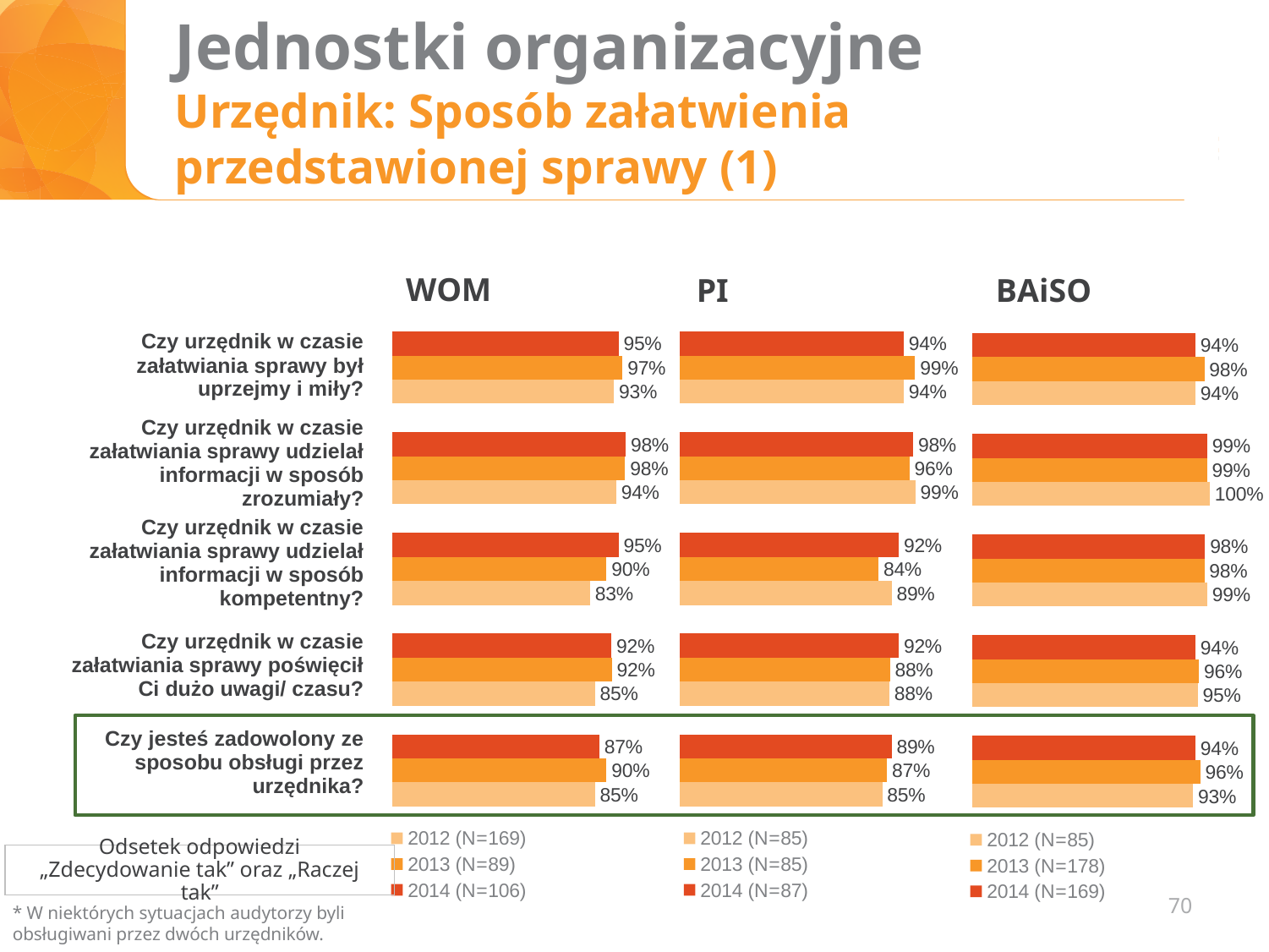
In the PI chart, which year has the highest value for "Czy urzędnik w czasie załatwiania sprawy był uprzejmy i miły?"? 2013 In the WOM chart, which year has the lowest value for "Czy urzędnik w czasie załatwiania sprawy udzielał informacji w sposób kompetentny?"? 2012 In the BAiSO chart, which is larger for "Czy jesteś zadowolony ze sposobu obsługi przez urzędnika?": the 2013 value or the 2012 value? 2013 In the BAiSO chart, what is the 2012 value for "Czy urzędnik w czasie załatwiania sprawy udzielał informacji w sposób zrozumiały?"? 100% In the WOM chart, what is the difference between the 2014 and 2012 values for "Czy urzędnik w czasie załatwiania sprawy udzielał informacji w sposób kompetentny?"? 12 percentage points In the WOM chart, what is the 2014 value for "Czy jesteś zadowolony ze sposobu obsługi przez urzędnika?"? 87% In the PI chart, what is the 2013 value for "Czy urzędnik w czasie załatwiania sprawy udzielał informacji w sposób kompetentny?"? 84% In the WOM chart, what is the difference between the 2013 and 2012 values for "Czy jesteś zadowolony ze sposobu obsługi przez urzędnika?"? 5 percentage points How many question categories are shown in the WOM chart? 5 How many series does the legend of the PI chart list? 3 What type of chart is used for the BAiSO data? Bar chart In the PI chart, what is the sample size (N) for 2014 shown in the legend? N=87